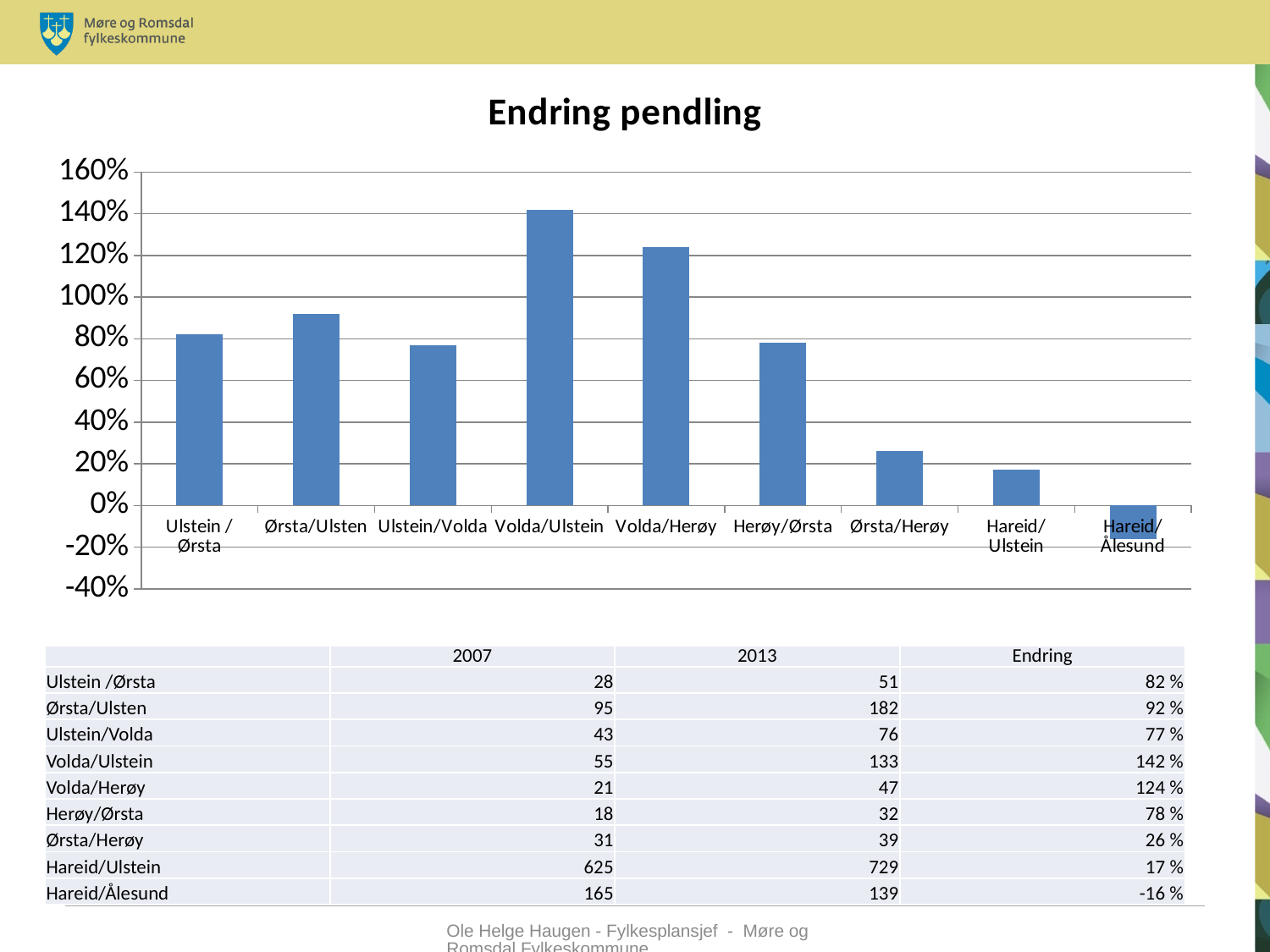
What is the Endring value for Ørsta/Ulsten? 92 % What is the Endring value for Hareid/Ålesund? -16 % What type of chart is shown on the slide? bar chart What is the difference between the Endring values for Volda/Ulstein and Volda/Herøy? 18 % What is the title of the chart? Endring pendling How many categories are plotted in the chart? 9 Which category has the lowest value in the chart? Hareid/Ålesund What is the Endring value for Volda/Ulstein? 142 % Is the value for Volda/Herøy greater or less than 100%? greater Which is larger, the value for Ørsta/Ulsten or the value for Ulstein/Volda? Ørsta/Ulsten Is the value for Ørsta/Herøy greater or less than 40%? less Which category has the highest value in the chart? Volda/Ulstein